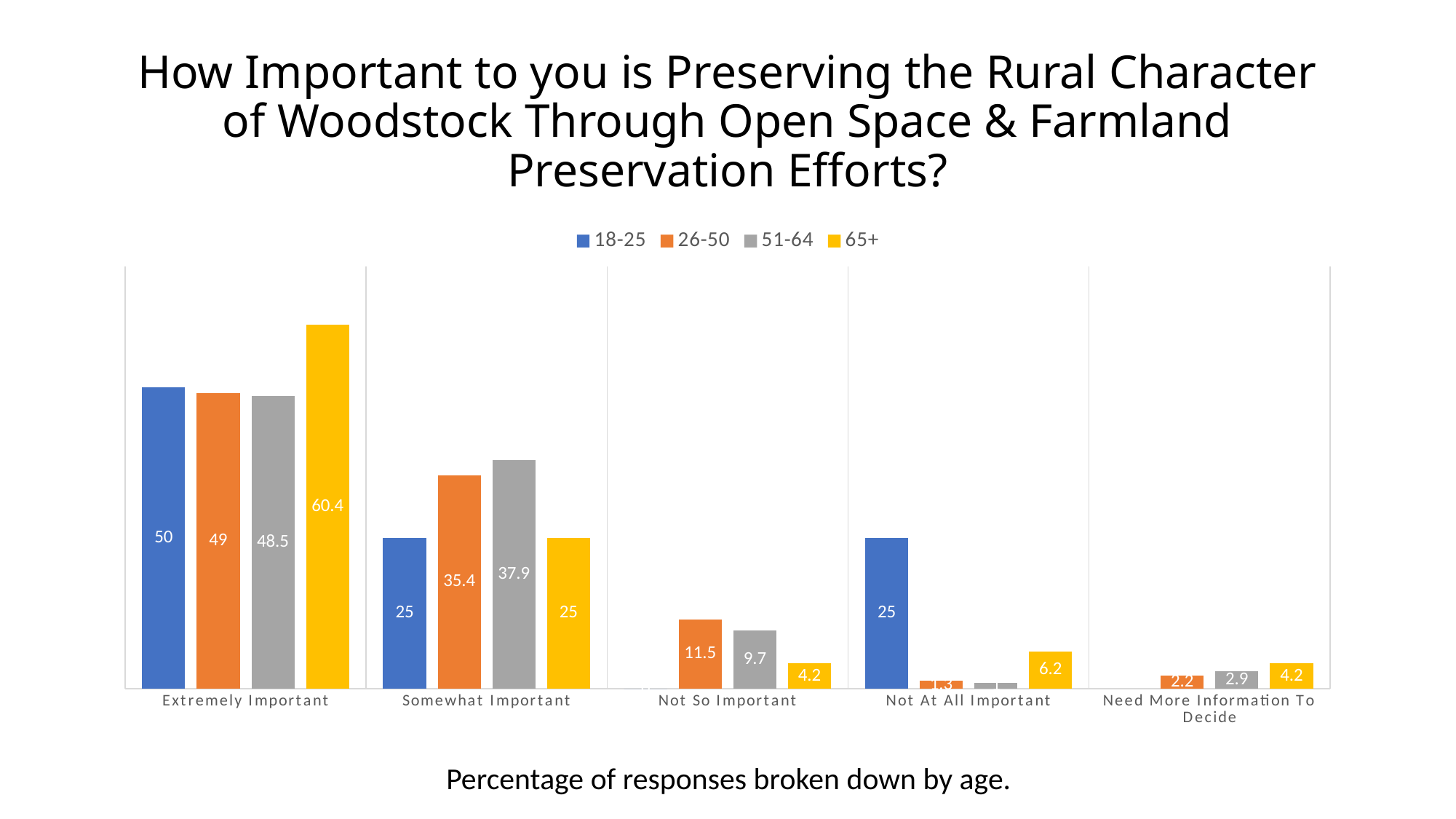
In the Not So Important category, which is larger: the value for 26-50 or the value for 51-64? 26-50 What is the value for the 18-25 age group in the Not At All Important category? 25 What kind of chart is shown on the slide? Bar chart How many response categories are shown on the x axis? 5 Which age group has the highest value in the Extremely Important category? 65+ Which age group has the highest value in the Somewhat Important category? 51-64 How many age groups does the legend list? 4 What is the value for the 51-64 age group in the Somewhat Important category? 37.9 In the Extremely Important category, how much higher is the 65+ value than the 18-25 value? 10.4 What percentage of the 65+ age group rated preserving rural character as Extremely Important? 60.4 What is the value for the 26-50 age group in the Not So Important category? 11.5 In the Somewhat Important category, what is the difference between the 51-64 value and the 26-50 value? 2.5